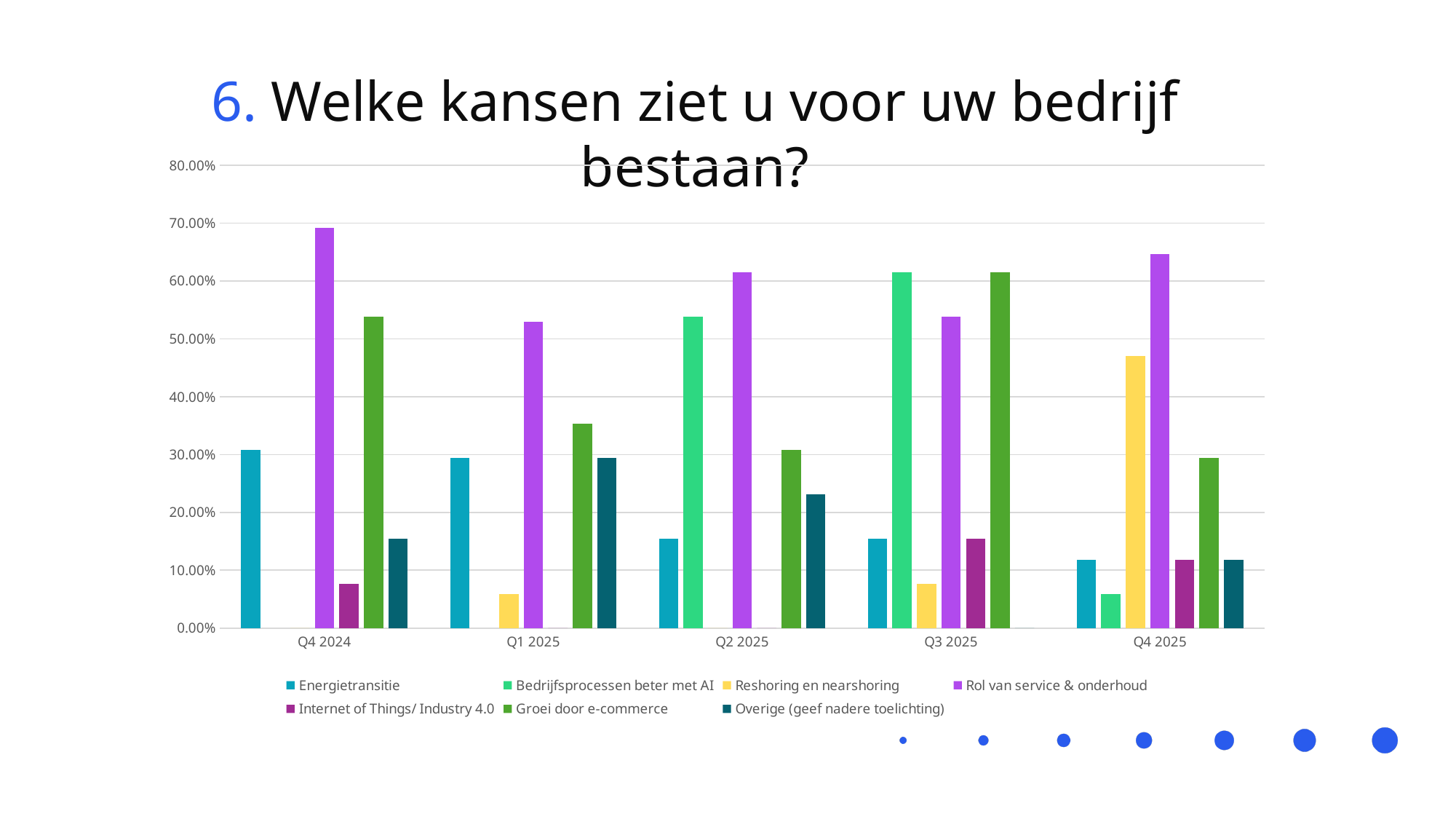
Is the value for Bedrijfsprocessen beter met AI in Q3 2025 greater or less than 50%? greater Is the value for Energietransitie in Q4 2024 greater or less than 40%? less In Q1 2025, which is larger: Groei door e-commerce or Overige (geef nadere toelichting)? Groei door e-commerce In Q4 2024, which series has the highest value? Rol van service & onderhoud How many quarters are shown on the x axis? 5 In which quarter is Rol van service & onderhoud at its highest? Q4 2024 In Q2 2025, which is larger: Bedrijfsprocessen beter met AI or Groei door e-commerce? Bedrijfsprocessen beter met AI What kind of chart is shown on the slide? Bar chart Is the value for Reshoring en nearshoring in Q4 2025 greater or less than 40%? greater How many series does the legend list? 7 Does the value for Energietransitie rise or fall from Q4 2024 to Q4 2025? fall